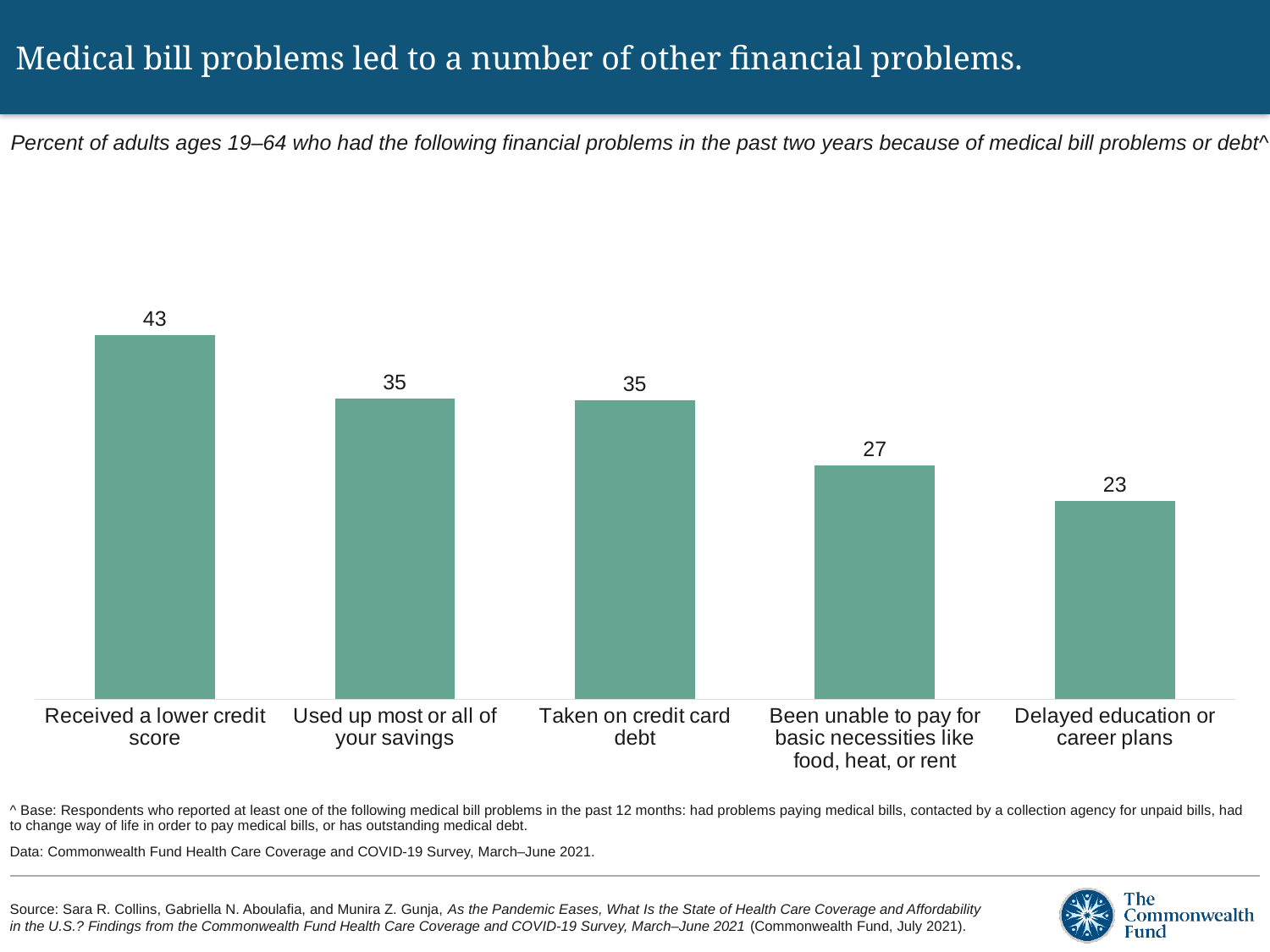
How many categories are shown in the chart? 5 What is the difference between the value for 'Used up most or all of your savings' and the value for 'Been unable to pay for basic necessities like food, heat, or rent'? 8 What is the value for 'Delayed education or career plans'? 23 Do 'Used up most or all of your savings' and 'Taken on credit card debt' have the same value? Yes, both are 35 Do the values rise or fall moving from left to right across the categories? Fall Which is larger: the value for 'Taken on credit card debt' or the value for 'Delayed education or career plans'? Taken on credit card debt What percent of adults received a lower credit score because of medical bill problems or debt? 43 What kind of chart is shown on the slide? Bar chart Which financial problem has the highest percentage? Received a lower credit score Which financial problem has the lowest percentage? Delayed education or career plans What is the difference between the value for 'Received a lower credit score' and the value for 'Delayed education or career plans'? 20 What is the value for 'Been unable to pay for basic necessities like food, heat, or rent'? 27